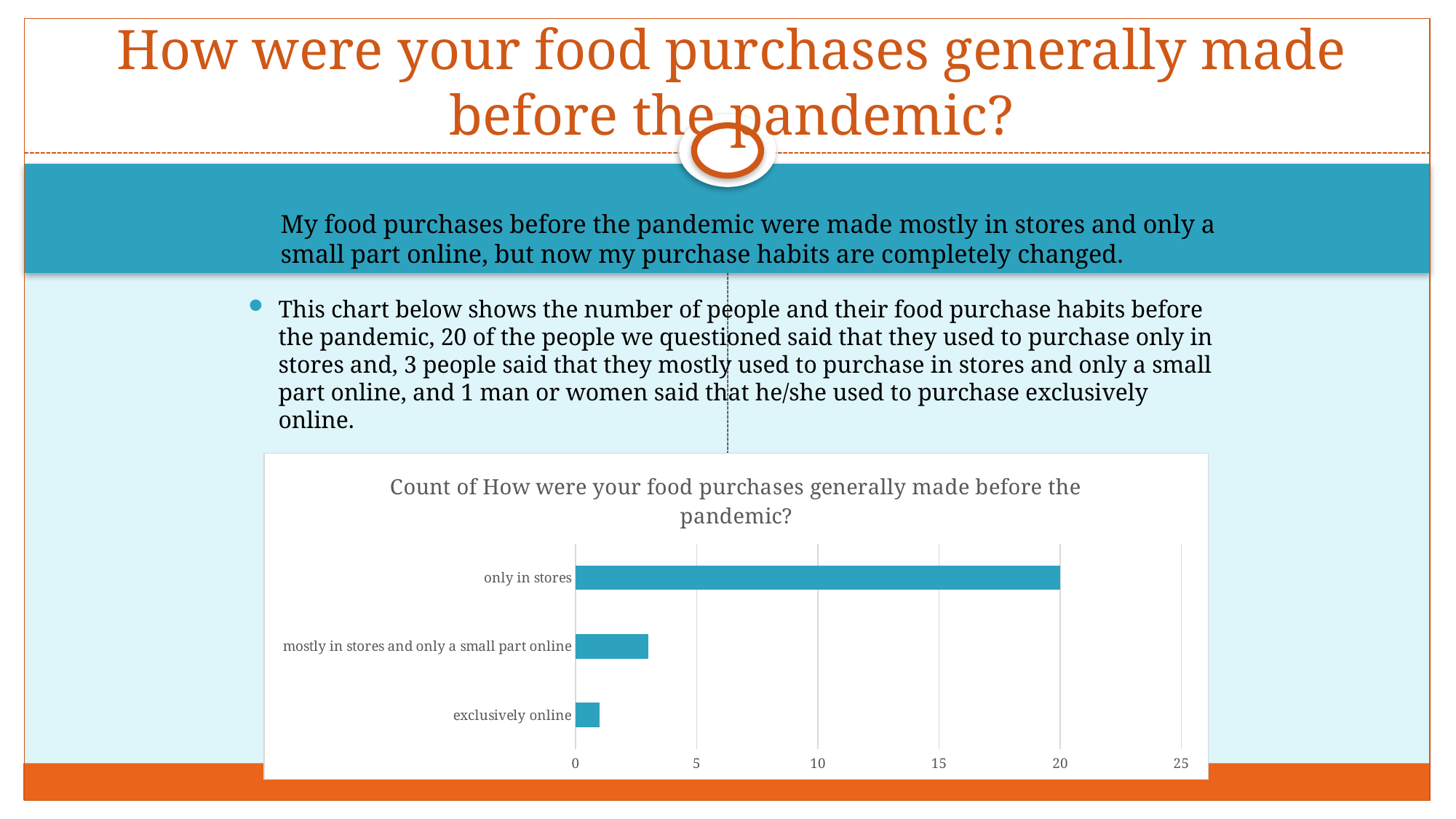
Which is larger: the value for "only in stores" or the value for "mostly in stores and only a small part online"? only in stores What is the value for "only in stores"? 20 What is the title of the chart? Count of How were your food purchases generally made before the pandemic? What kind of chart is shown on the slide? bar chart What is the highest tick value shown on the horizontal axis of the chart? 25 Which category has the lowest value in the chart? exclusively online Is the value for "mostly in stores and only a small part online" greater or less than 5? less Is the value for "exclusively online" greater or less than 5? less Is the value for "only in stores" greater or less than 15? greater Which category has the highest value in the chart? only in stores How many categories are shown in the chart? 3 Which is larger: the value for "mostly in stores and only a small part online" or the value for "exclusively online"? mostly in stores and only a small part online